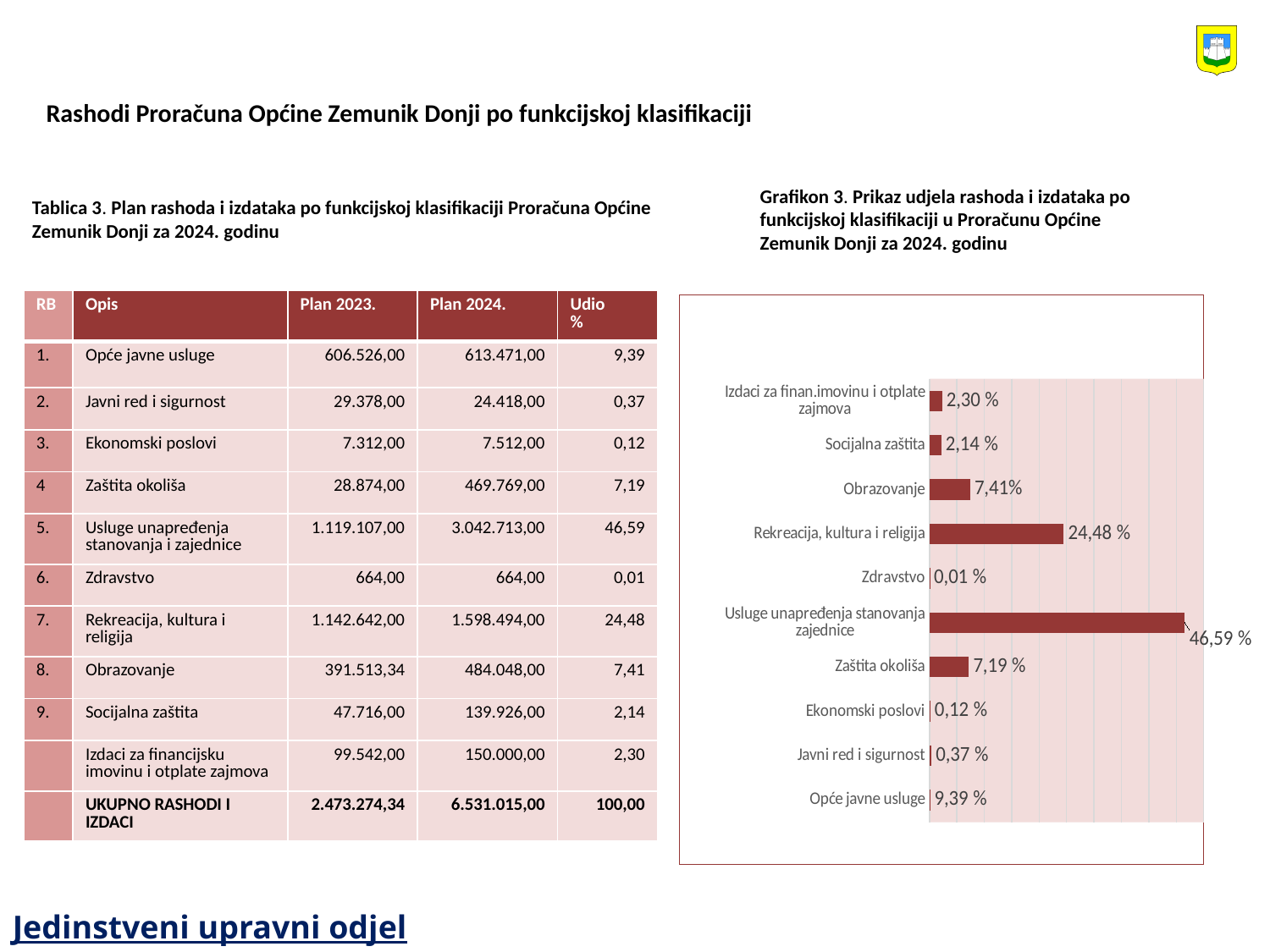
Which category has the highest share in the chart? Usluge unapređenja stanovanja zajednice What type of chart is shown on the slide? Bar chart How many categories are plotted in the chart? 10 What is the difference between the shares of Usluge unapređenja stanovanja zajednice and Rekreacija, kultura i religija? 22,11 % What share does the chart show for Obrazovanje? 7,41% What is the value labelled for Socijalna zaštita? 2,14 % What is the difference between the shares of Zaštita okoliša and Izdaci za finan.imovinu i otplate zajmova? 4,89 % What is the value shown for Rekreacija, kultura i religija in the chart? 24,48 % What value is shown for Zdravstvo in the chart? 0,01 % Which has the larger share, Rekreacija, kultura i religija or Obrazovanje? Rekreacija, kultura i religija Which category has the lowest share in the chart? Zdravstvo What is the title of the chart on the slide? Grafikon 3. Prikaz udjela rashoda i izdataka po funkcijskoj klasifikaciji u Proračunu Općine Zemunik Donji za 2024. godinu